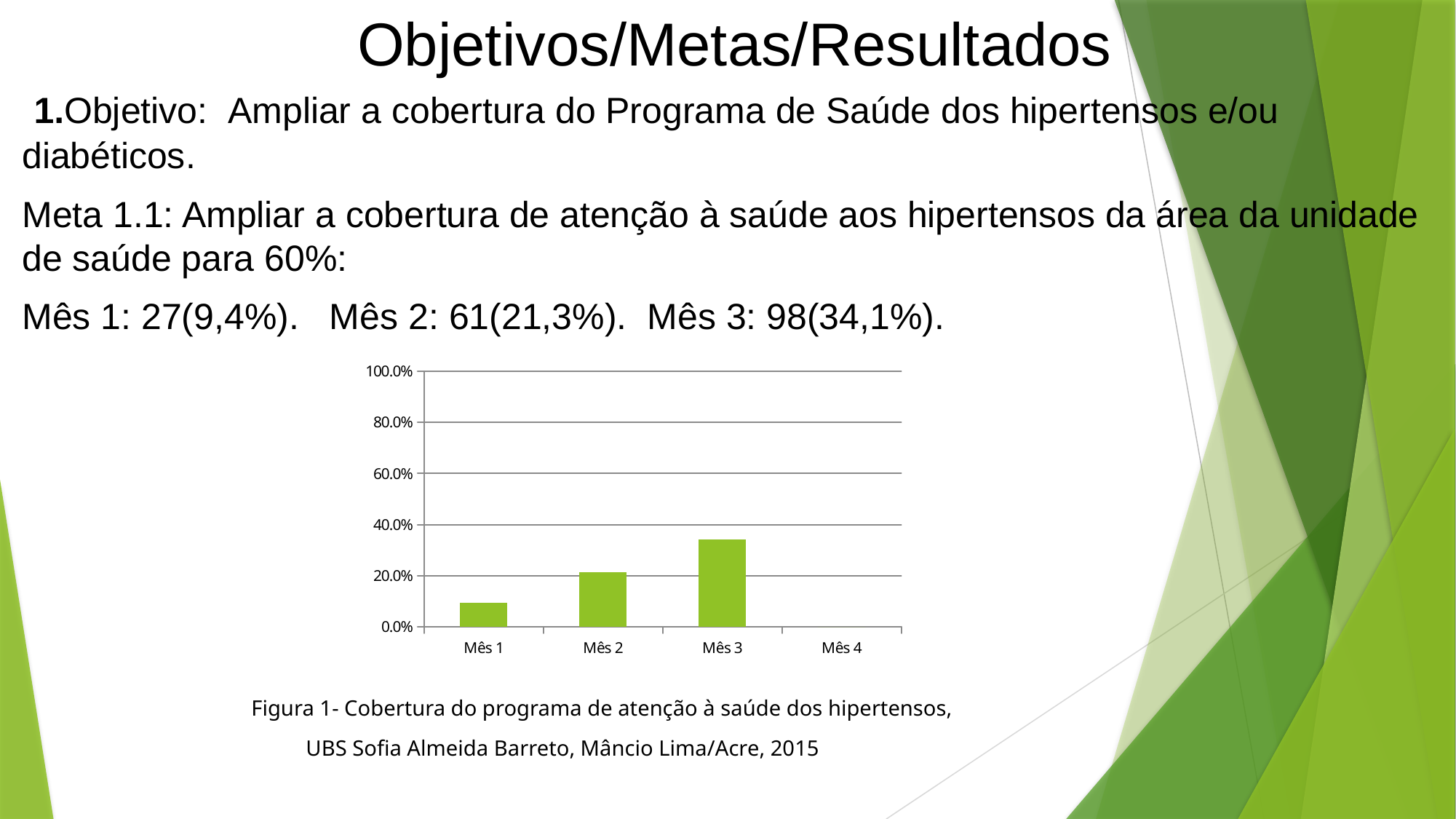
What is the highest value shown on the chart's y axis? 100.0% Is the value for Mês 2 greater or less than 20.0%? greater According to the slide, what coverage percentage was reached in Mês 1? 9,4% Do the bar values rise or fall from Mês 1 to Mês 3? rise What type of chart is shown on the slide? bar chart Is the value for Mês 1 greater or less than 20.0%? less Among the three months with plotted bars, which has the lowest value? Mês 1 According to the slide, what coverage percentage was reached in Mês 3? 34,1% How many month categories are shown on the x axis of the chart? 4 Is the value for Mês 3 greater or less than 40.0%? less Which is larger, the value for Mês 2 or the value for Mês 3? Mês 3 Which month has the tallest bar in the chart? Mês 3